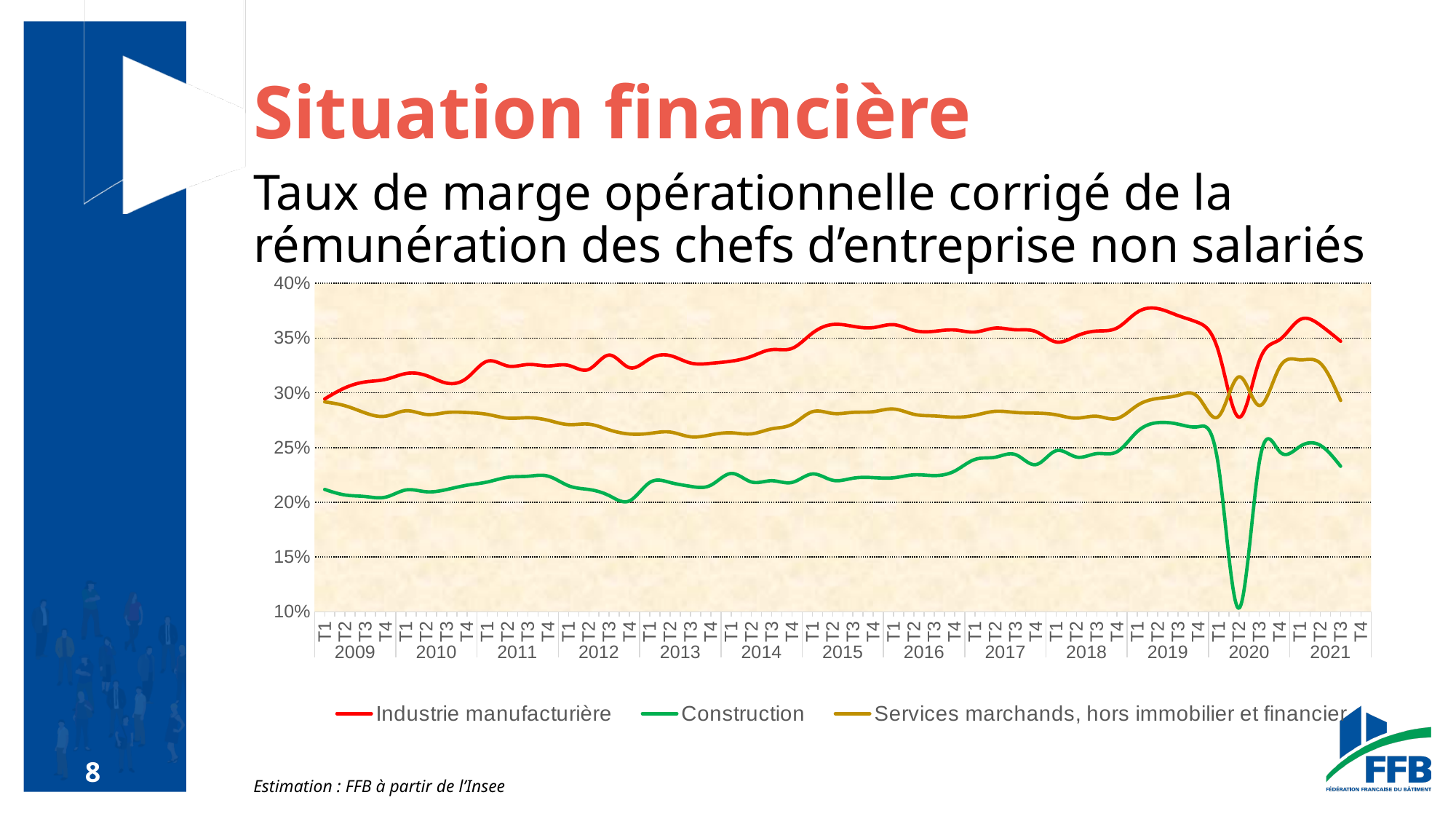
Is the value for Industrie manufacturière in 2019 T2 greater or less than 35%? greater Does the Construction series rise or fall overall from 2009 to 2019? rise Is the value for Construction in 2020 T2 greater or less than 15%? less What kind of chart is shown on the slide? line chart Which series is plotted in green? Construction Is the value for Services marchands, hors immobilier et financier in 2021 T1 greater or less than 30%? greater How many years are labelled on the x axis? 13 In 2015 T1, which is larger: Industrie manufacturière or Construction? Industrie manufacturière How many series does the legend list? 3 Which series is plotted in red? Industrie manufacturière Which series has the lowest values across the whole period? Construction